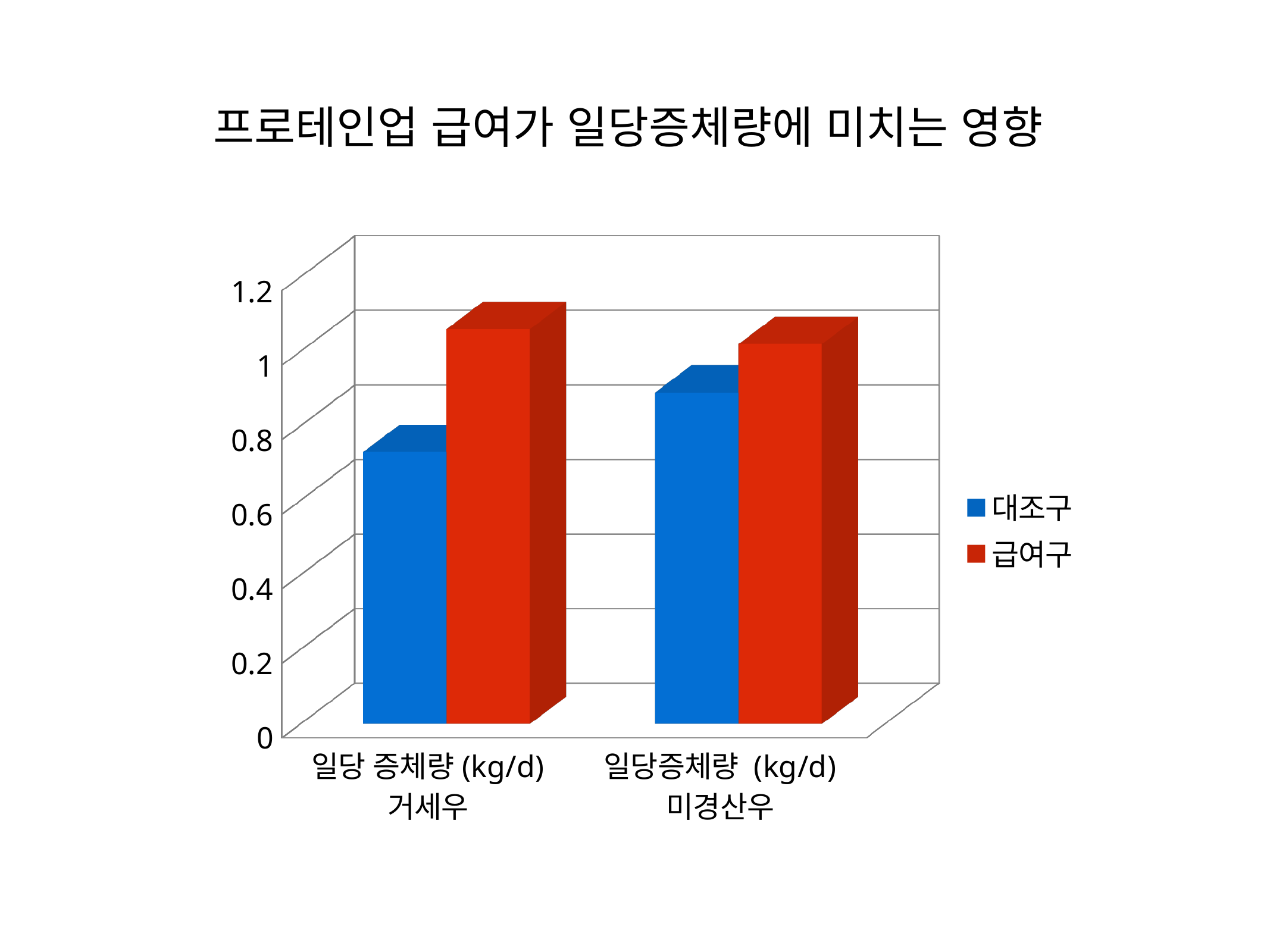
For 미경산우, which is larger: 대조구 or 급여구? 급여구 How many categories are shown on the x axis? 2 Is the 대조구 value for 미경산우 greater or less than 0.8? greater Which series is shown in red in the legend? 급여구 Is the 급여구 value for 거세우 greater or less than 1? greater Which bar is the lowest in the chart? 대조구 for 거세우 For 거세우, which is larger: 대조구 or 급여구? 급여구 What kind of chart is shown on the slide? bar chart How many series does the legend list? 2 Is the 대조구 value for 거세우 greater or less than 1? less What is the title of the chart? 프로테인업 급여가 일당증체량에 미치는 영향